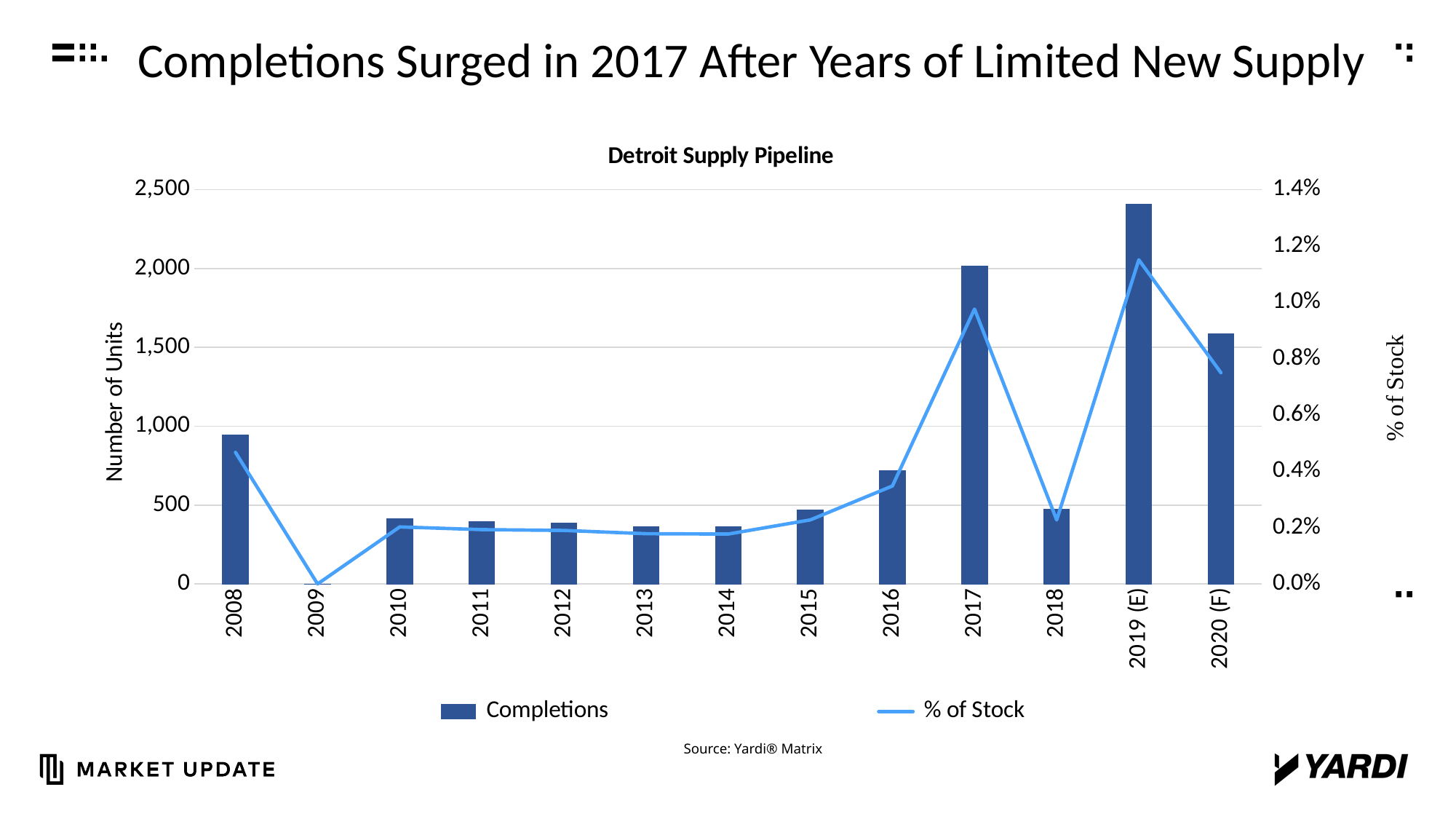
Did the number of completions rise or fall from 2016 to 2017? Rise What kind of chart is the Detroit Supply Pipeline chart? A combination bar and line chart Which year has the lowest number of completions in the Detroit Supply Pipeline chart? 2009 How many series does the legend of the Detroit Supply Pipeline chart list? 2 Is the number of completions for 2019 (E) greater or less than 2,000? greater Is the number of completions for 2008 greater or less than 1,000? less Which year has the highest number of completions in the Detroit Supply Pipeline chart? 2019 (E) Which year had more completions, 2017 or 2020 (F)? 2017 Is the % of Stock value for 2019 (E) greater or less than 1.0%? greater How many years are shown on the x axis of the Detroit Supply Pipeline chart? 13 What is the label of the right-hand vertical axis in the Detroit Supply Pipeline chart? % of Stock